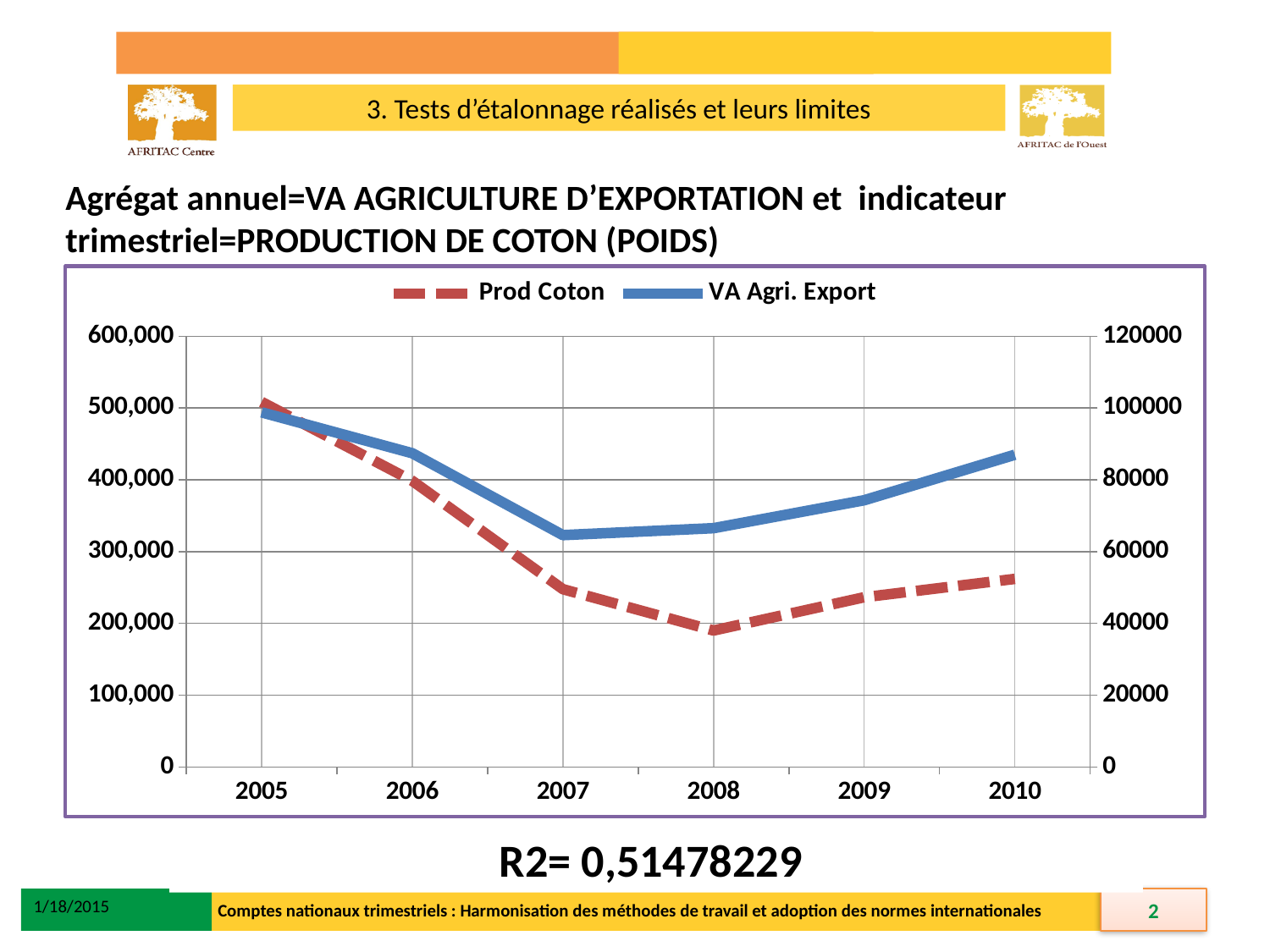
How many series does the chart legend list? 2 In which year does the VA Agri. Export series reach its lowest point? 2007 Does the Prod Coton series rise or fall between 2008 and 2010? rise In which year is the Prod Coton series at its highest? 2005 What R2 value is printed below the chart? 0,51478229 In which year does the Prod Coton series reach its lowest point? 2008 Is the Prod Coton value higher in 2005 or in 2010? 2005 What kind of chart is shown on the slide? line chart How many years are plotted along the x axis of the chart? 6 Does the VA Agri. Export series rise or fall between 2005 and 2007? fall Which series is drawn with a red dashed line? Prod Coton In which year is the VA Agri. Export series at its highest? 2005